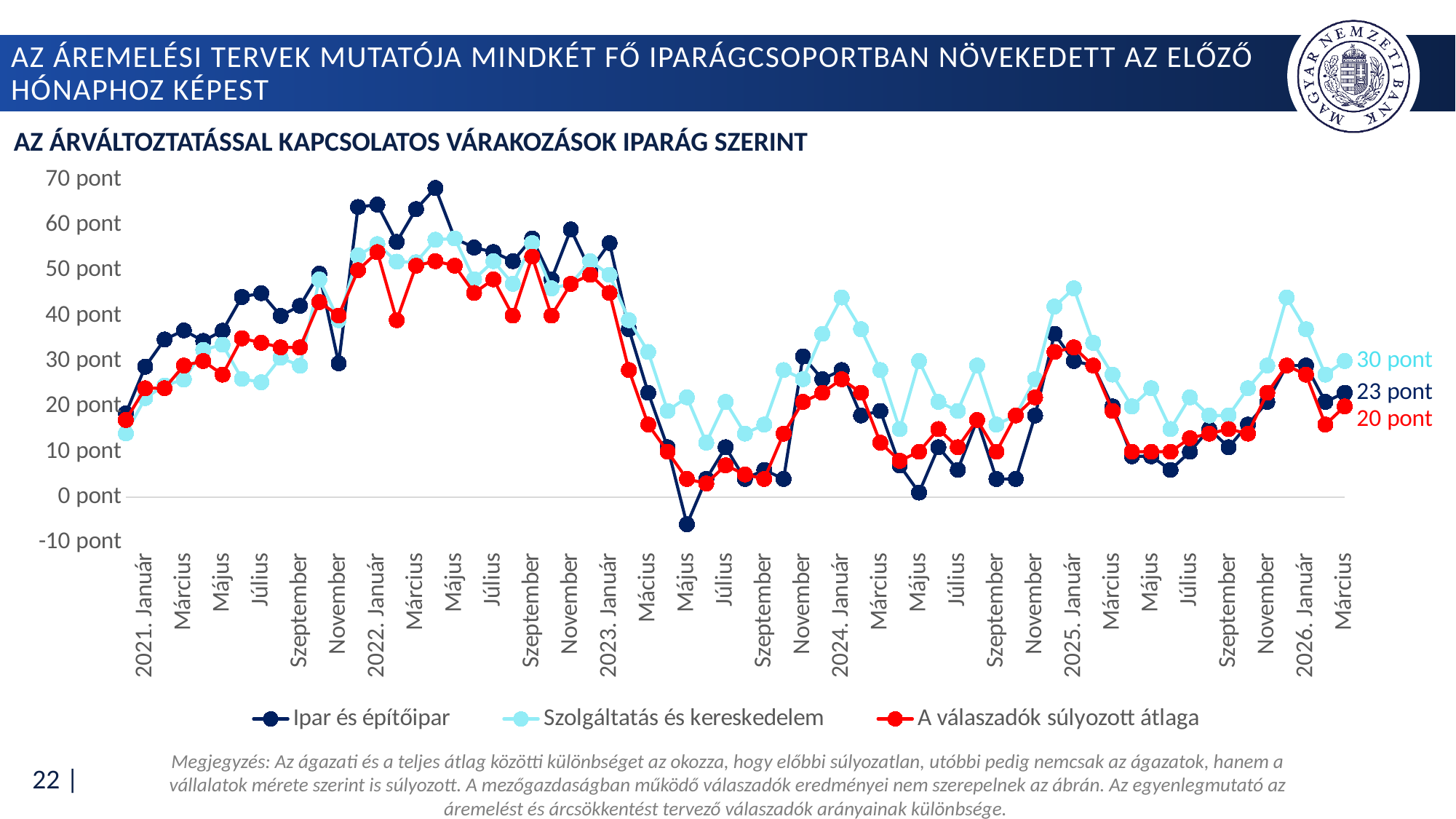
Is the value for Ipar és építőipar in 2023 Május greater or less than 0 pont? less Is the value for Ipar és építőipar in 2022 Május greater or less than 60 pont? less How many series does the legend list? 3 At the last data point, which series is higher: Ipar és építőipar or Szolgáltatás és kereskedelem? Szolgáltatás és kereskedelem What kind of chart is shown on the slide? line chart What is the title of the chart? AZ ÁRVÁLTOZTATÁSSAL KAPCSOLATOS VÁRAKOZÁSOK IPARÁG SZERINT At the last data point, what is the difference between Ipar és építőipar and A válaszadók súlyozott átlaga? 3 pont What is the latest value (2026. Március) for A válaszadók súlyozott átlaga? 20 pont What is the latest value (2026. Március) for Szolgáltatás és kereskedelem? 30 pont At the last data point, what is the difference between Szolgáltatás és kereskedelem and Ipar és építőipar? 7 pont What is the latest value (2026. Március) for Ipar és építőipar? 23 pont Which series has the highest value at the last data point (2026. Március)? Szolgáltatás és kereskedelem